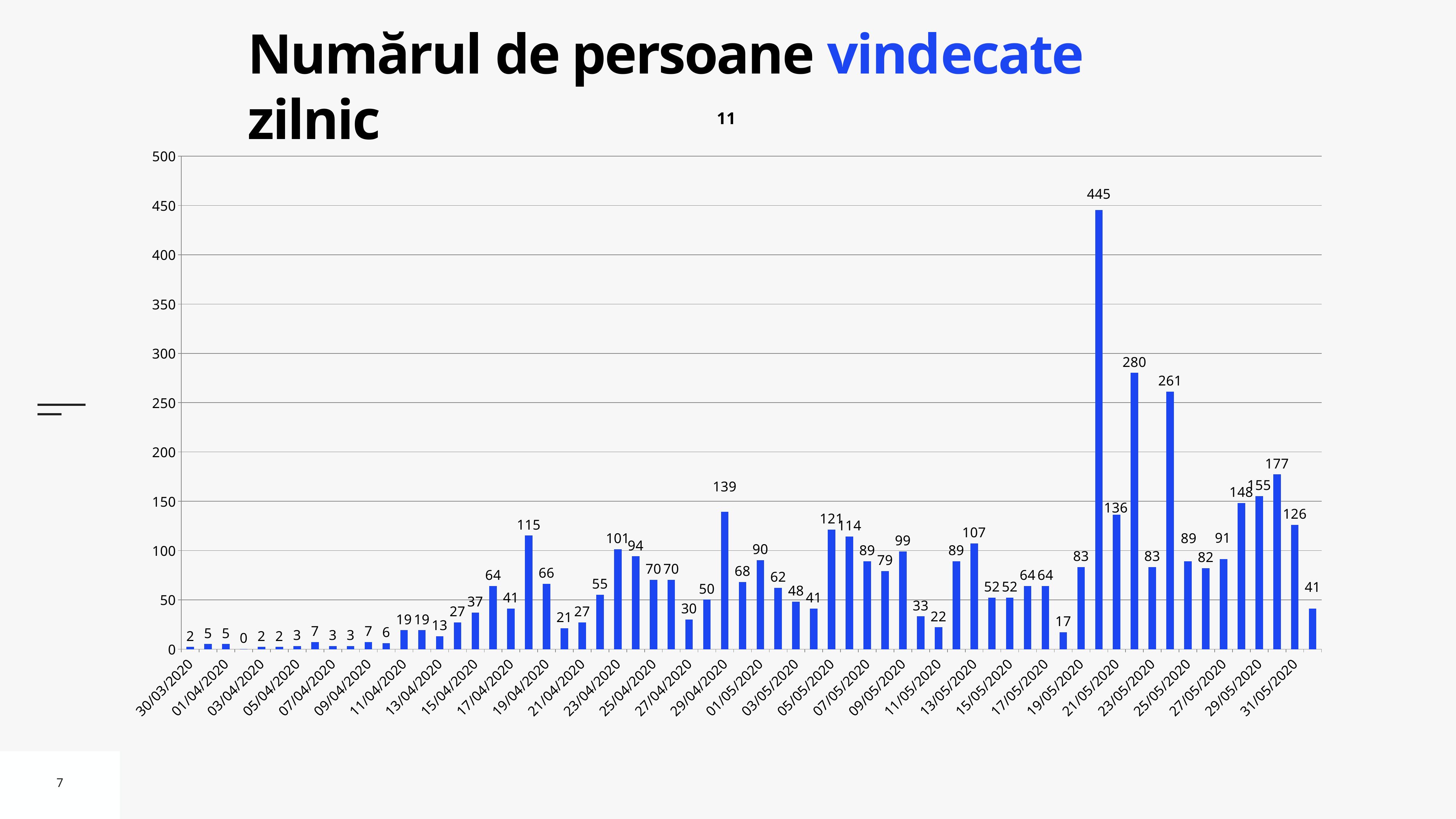
What kind of chart is shown on the slide? bar chart What is the difference between the values for 13/05/2020 and 11/05/2020? 85 What is the value for 29/04/2020? 139 What is the value for 21/05/2020? 136 Is the value for 19/04/2020 greater or less than 50? greater What is the title of the slide? Numărul de persoane vindecate zilnic What is the lowest value shown on the chart? 0 What is the highest value shown on the chart? 445 What is the difference between the values for 29/05/2020 and 31/05/2020? 29 What is the value for 17/04/2020? 41 What is the value for 13/05/2020? 107 Which has a larger value, 23/04/2020 or 05/05/2020? 05/05/2020